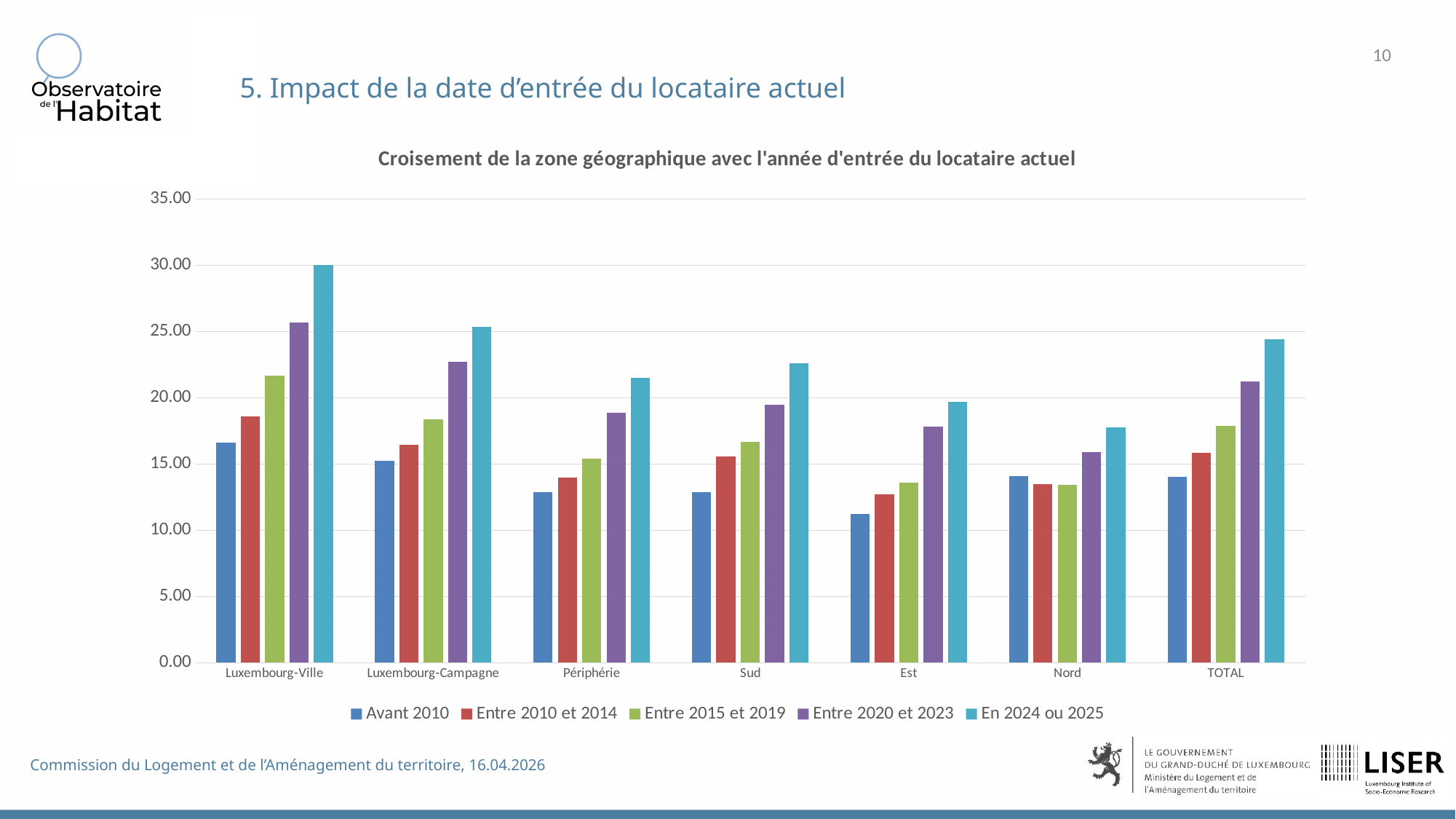
Which category has the highest bar for the series 'En 2024 ou 2025'? Luxembourg-Ville Which category has the lowest bar for the series 'Avant 2010'? Est Is the value for 'Entre 2020 et 2023' in TOTAL greater or less than 20.00? greater In the TOTAL category, do the bars rise or fall from 'Avant 2010' to 'En 2024 ou 2025'? rise How many geographic categories are shown on the x axis? 7 Is the value for 'En 2024 ou 2025' in Luxembourg-Ville greater or less than 25.00? greater Is the value for 'Avant 2010' in Est greater or less than 15.00? less Within the Nord category, which series has the highest bar? En 2024 ou 2025 What kind of chart is shown on the slide? bar chart How many series does the legend list? 5 For the series 'En 2024 ou 2025', which is larger: Luxembourg-Campagne or Sud? Luxembourg-Campagne What is the title of the chart? Croisement de la zone géographique avec l'année d'entrée du locataire actuel